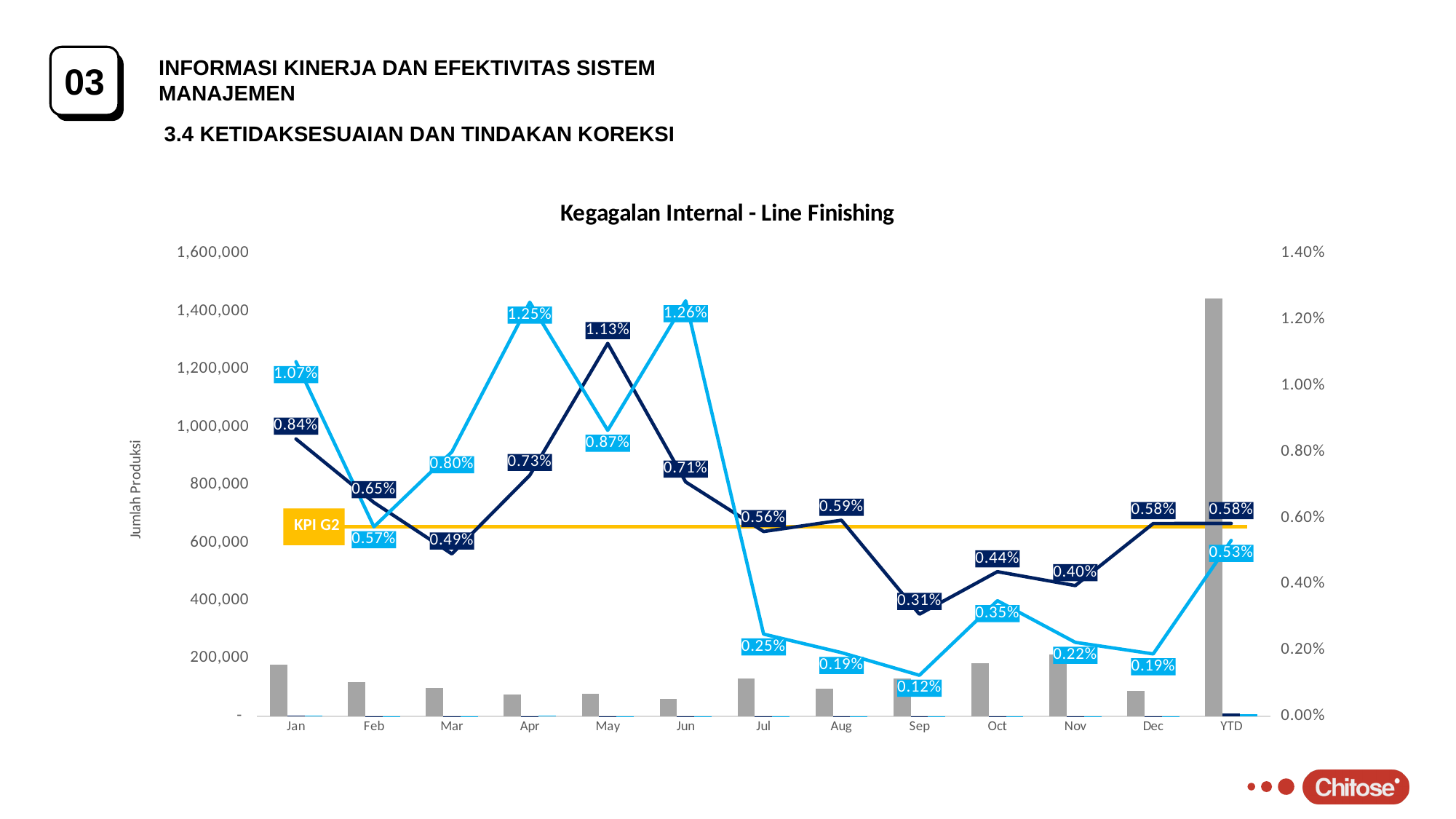
What value does the light blue line show for YTD? 0.53% What kind of chart is shown on the slide? combination bar and line chart What is the difference between the dark blue line's values for Jan and Feb? 0.19% Is the value of the gray bar for Jan greater or less than 200,000? less What value does the dark blue line show for May? 1.13% For Apr, which line has the larger value, the light blue line or the dark blue line? light blue line In which month does the light blue line reach its lowest value? Sep How many categories are shown on the x axis of the chart? 13 What is the title of the chart? Kegagalan Internal - Line Finishing In which month does the dark blue line reach its highest value? May In which month does the dark blue line reach its lowest value? Sep What value does the light blue line show for Jun? 1.26%